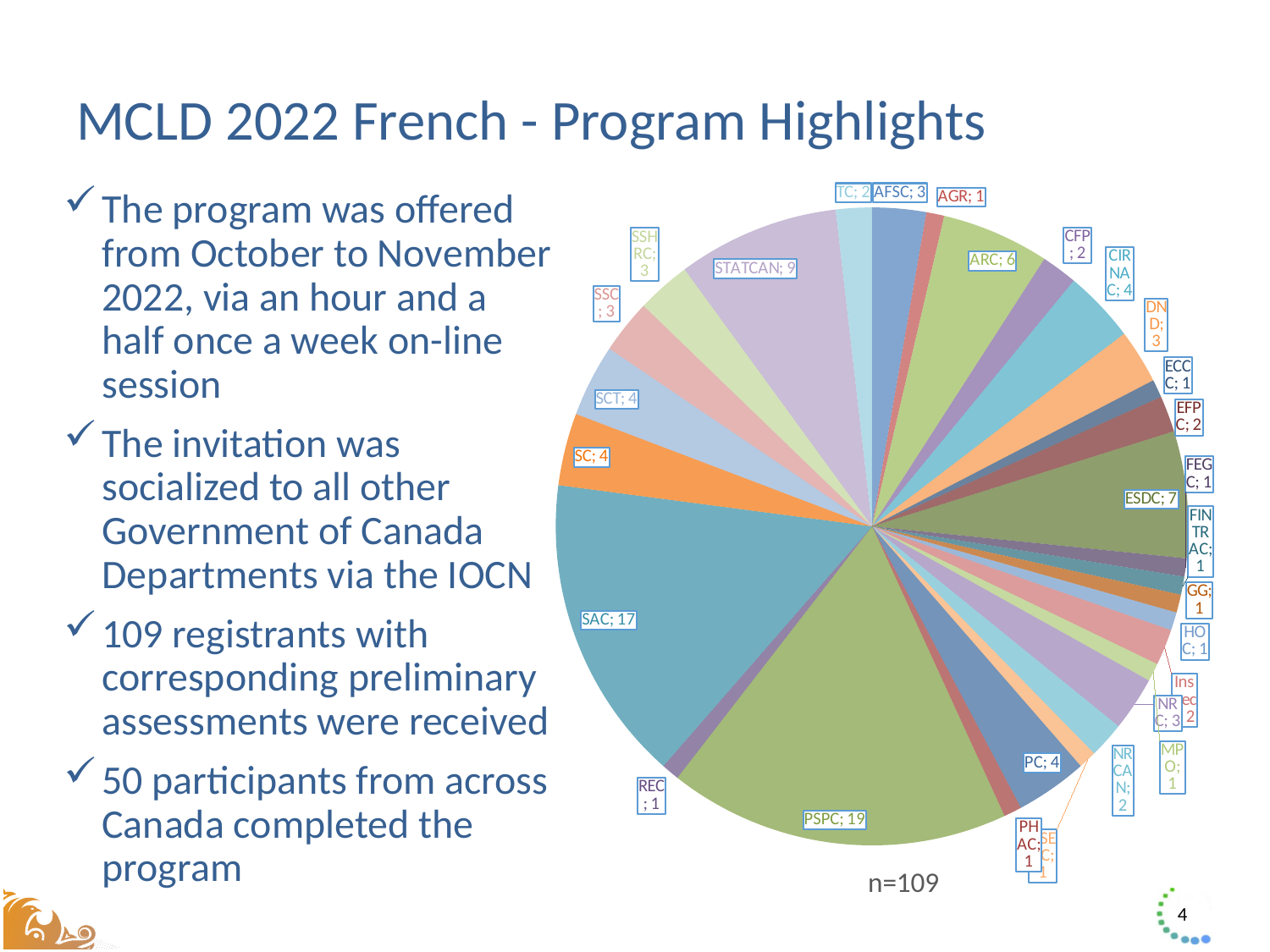
What is the difference between the values for PSPC and SAC? 2 Which category has the largest slice in the pie chart? PSPC What is the value for ESDC in the pie chart? 7 What is the value for PSPC in the pie chart? 19 What is the value for STATCAN in the pie chart? 9 What type of chart is shown on the slide? pie chart What total n is shown below the pie chart? n=109 What is the difference between the values for SAC and STATCAN? 8 What is the value for CIRNAC in the pie chart? 4 What is the value for SAC in the pie chart? 17 What is the value for ARC in the pie chart? 6 Which is larger, the value for STATCAN or the value for ESDC? STATCAN